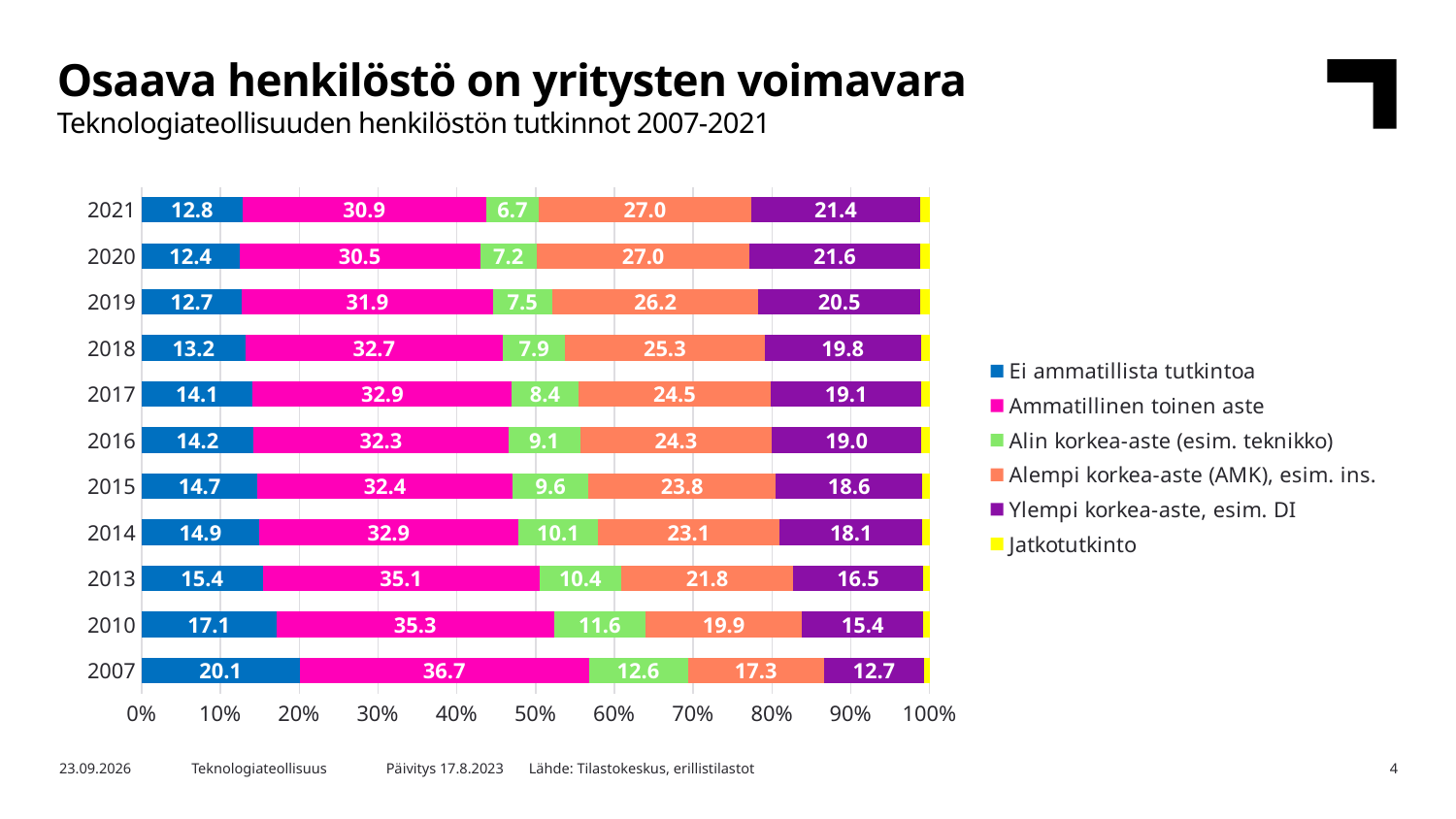
What kind of chart is shown on the slide? Stacked bar chart What is the value for Ylempi korkea-aste, esim. DI in 2018? 19.8 In which year is the value for Alin korkea-aste (esim. teknikko) the lowest? 2021 In which year is the value for Ei ammatillista tutkintoa the highest? 2007 Which is larger in 2016: Alempi korkea-aste (AMK), esim. ins. or Ylempi korkea-aste, esim. DI? Alempi korkea-aste (AMK), esim. ins. What is the difference between the Ei ammatillista tutkintoa values for 2007 and 2021? 7.3 What is the value for Ei ammatillista tutkintoa in 2007? 20.1 How many series does the legend list? 6 What is the value for Alin korkea-aste (esim. teknikko) in 2015? 9.6 How many years are shown on the chart? 11 What is the value for Ammatillinen toinen aste in 2021? 30.9 Does the value for Ei ammatillista tutkintoa rise or fall from 2007 to 2021? Fall